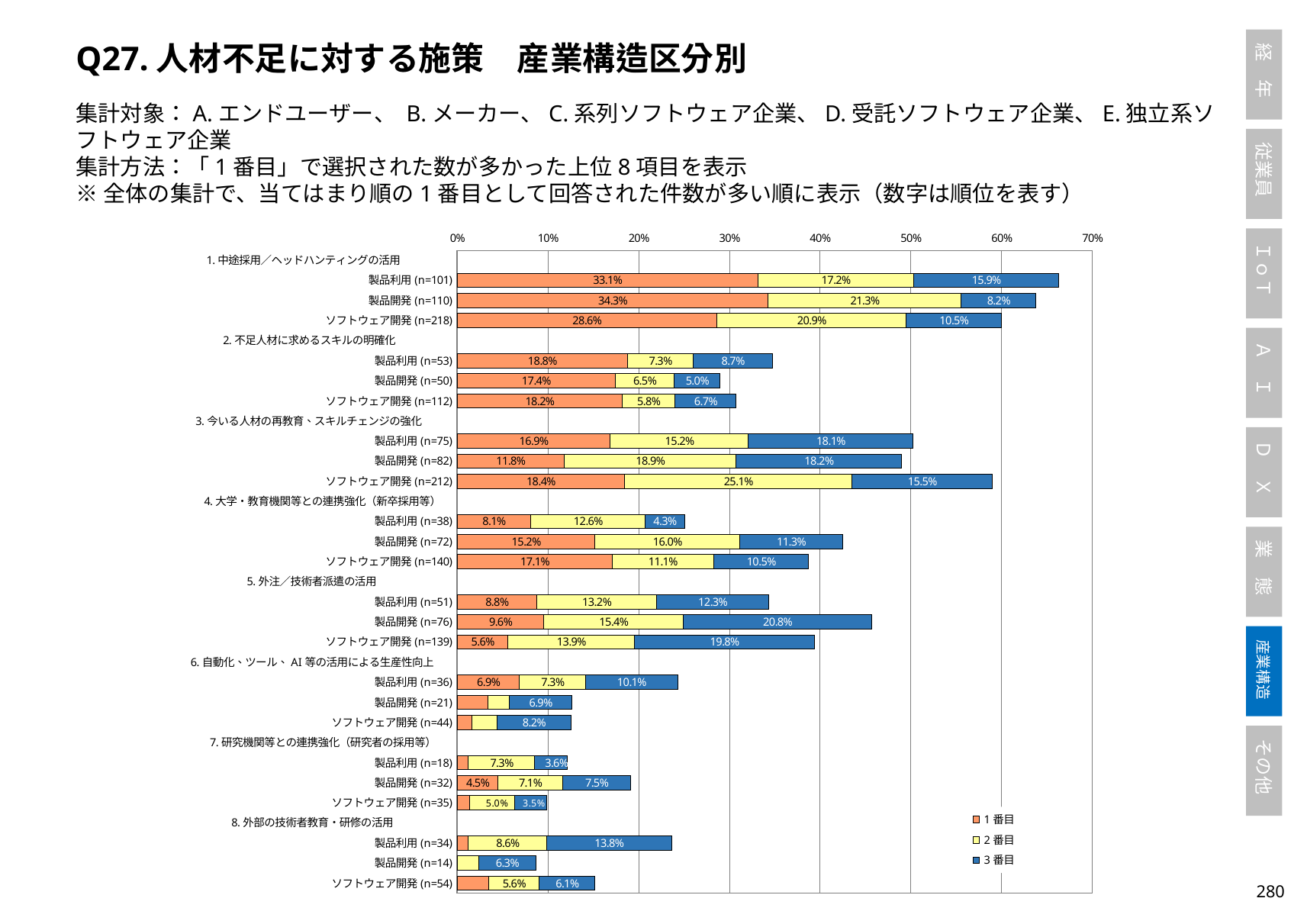
Among the three rows under item 1, which has the highest 1番目 value? 製品開発 (n=110) What is the 1番目 value for 製品利用 (n=53) under item 2 (不足人材に求めるスキルの明確化)? 18.8% Is the total stacked bar for ソフトウェア開発 (n=218) under item 1 greater or less than 50%? greater What is the 3番目 value for 製品開発 (n=76) under item 5 (外注／技術者派遣の活用)? 20.8% What kind of chart is shown on the slide? Stacked horizontal bar chart What is the 2番目 value for ソフトウェア開発 (n=212) under item 3 (今いる人材の再教育、スキルチェンジの強化)? 25.1% What is the 1番目 value for 製品開発 (n=110) under item 1 (中途採用／ヘッドハンティングの活用)? 34.3% How many series does the legend list? 3 What is the difference between the 1番目 values for 製品開発 (n=110) and ソフトウェア開発 (n=218) under item 1? 5.7 percentage points Under item 3, which has the larger 2番目 value: 製品利用 (n=75) or 製品開発 (n=82)? 製品開発 (n=82) What is the total of the stacked bar for 製品利用 (n=101) under item 1? 66.2% What is the total of the stacked bar for 製品開発 (n=32) under item 7 (研究機関等との連携強化)? 19.1%